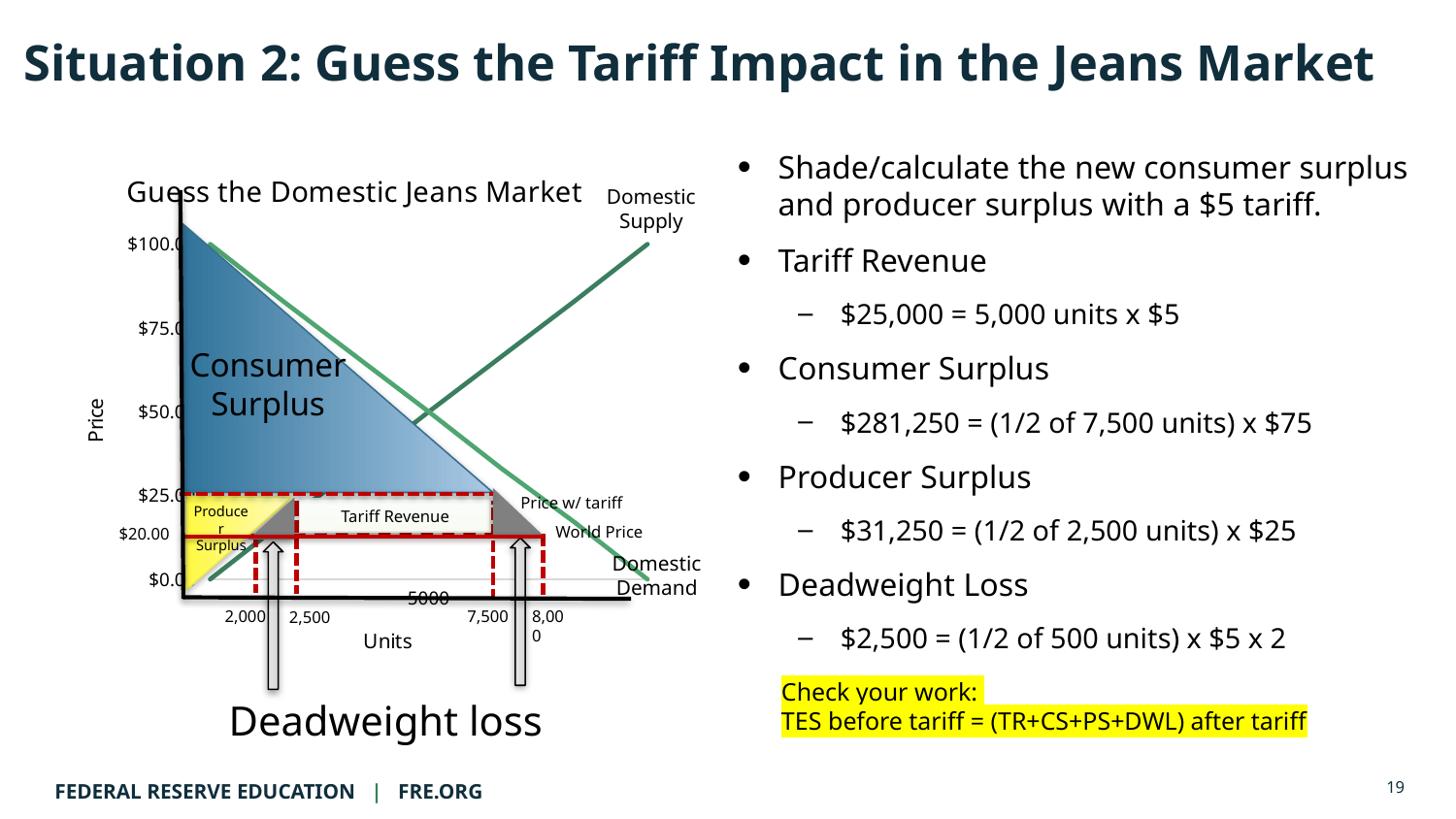
Is the price where Domestic Supply and Domestic Demand intersect greater or less than $25.00? greater What price is labeled as the World Price on the chart? $20.00 Does the Domestic Demand line rise or fall as Units increase? fall Which line on the chart rises as Units increase along the x axis? Domestic Supply What is the difference between the Price w/ tariff and the World Price on the chart? $5.00 How many unit values are labeled along the x axis of the chart? 5 What is the region between the Price w/ tariff line and the World Price line labeled on the chart? Tariff Revenue What is the highest price tick shown on the y axis of the chart? $100.00 What is the title of the chart? Guess the Domestic Jeans Market Which of the two horizontal price lines is higher on the chart, Price w/ tariff or World Price? Price w/ tariff What kind of chart is shown on the slide? line chart What price level does the 'Price w/ tariff' line sit at on the chart? $25.00